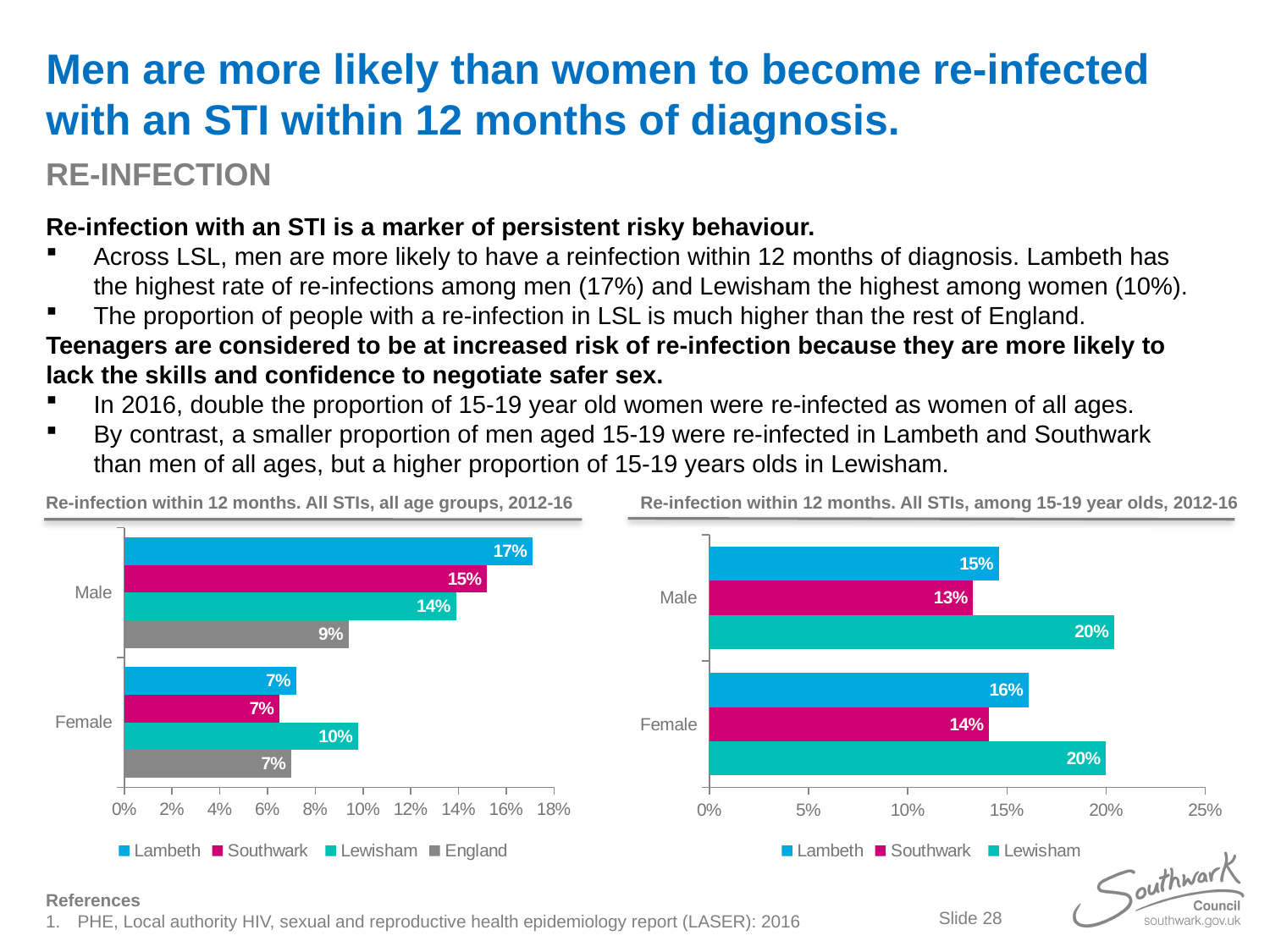
In the chart 'Re-infection within 12 months. All STIs, among 15-19 year olds, 2012-16', how many series does the legend list? 3 What type of chart is the chart on the right of the slide? Bar chart In the chart 'Re-infection within 12 months. All STIs, among 15-19 year olds, 2012-16', what is the value for Southwark among females? 14% In the chart 'Re-infection within 12 months. All STIs, all age groups, 2012-16', what is the value for England among females? 7% In the chart 'Re-infection within 12 months. All STIs, among 15-19 year olds, 2012-16', which series has the lowest value for males? Southwark In the chart 'Re-infection within 12 months. All STIs, all age groups, 2012-16', which series has the highest value for males? Lambeth In the chart 'Re-infection within 12 months. All STIs, all age groups, 2012-16', what is the difference between the Lambeth male value and the England male value? 8% In the chart 'Re-infection within 12 months. All STIs, all age groups, 2012-16', how many series does the legend list? 4 In the chart 'Re-infection within 12 months. All STIs, all age groups, 2012-16', what is the value for Lambeth among males? 17% In the chart 'Re-infection within 12 months. All STIs, among 15-19 year olds, 2012-16', is the Lambeth value larger for males or for females? Females In the chart 'Re-infection within 12 months. All STIs, all age groups, 2012-16', which series has the highest value for females? Lewisham In the chart 'Re-infection within 12 months. All STIs, among 15-19 year olds, 2012-16', what is the value for Lewisham among males? 20%